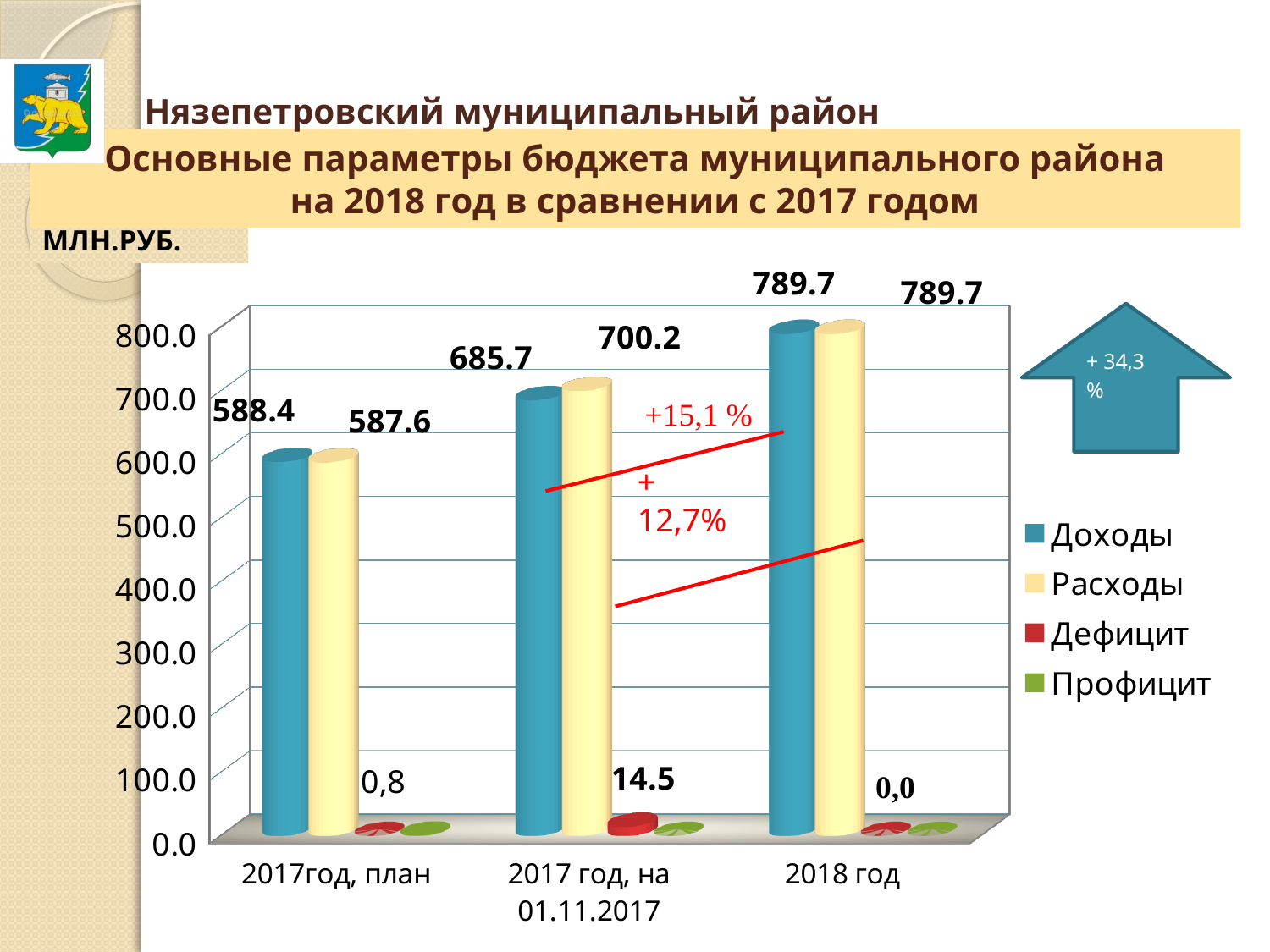
What is the value of Доходы for 2018 год? 789.7 Which category has the lowest value of Расходы? 2017год, план What is the value of Доходы for 2017год, план? 588.4 What is the value of Расходы for 2017год, план? 587.6 What is the value of Расходы for 2017 год, на 01.11.2017? 700.2 How many series does the legend list? 4 For 2017 год, на 01.11.2017, which is larger: Доходы or Расходы? Расходы How many categories are shown on the x axis? 3 Which category has the highest value of Доходы? 2018 год By how much do Доходы for 2018 год exceed Доходы for 2017год, план? 201.3 Do the values of Доходы rise or fall from 2017год, план to 2018 год? rise What kind of chart is shown on the slide? bar chart